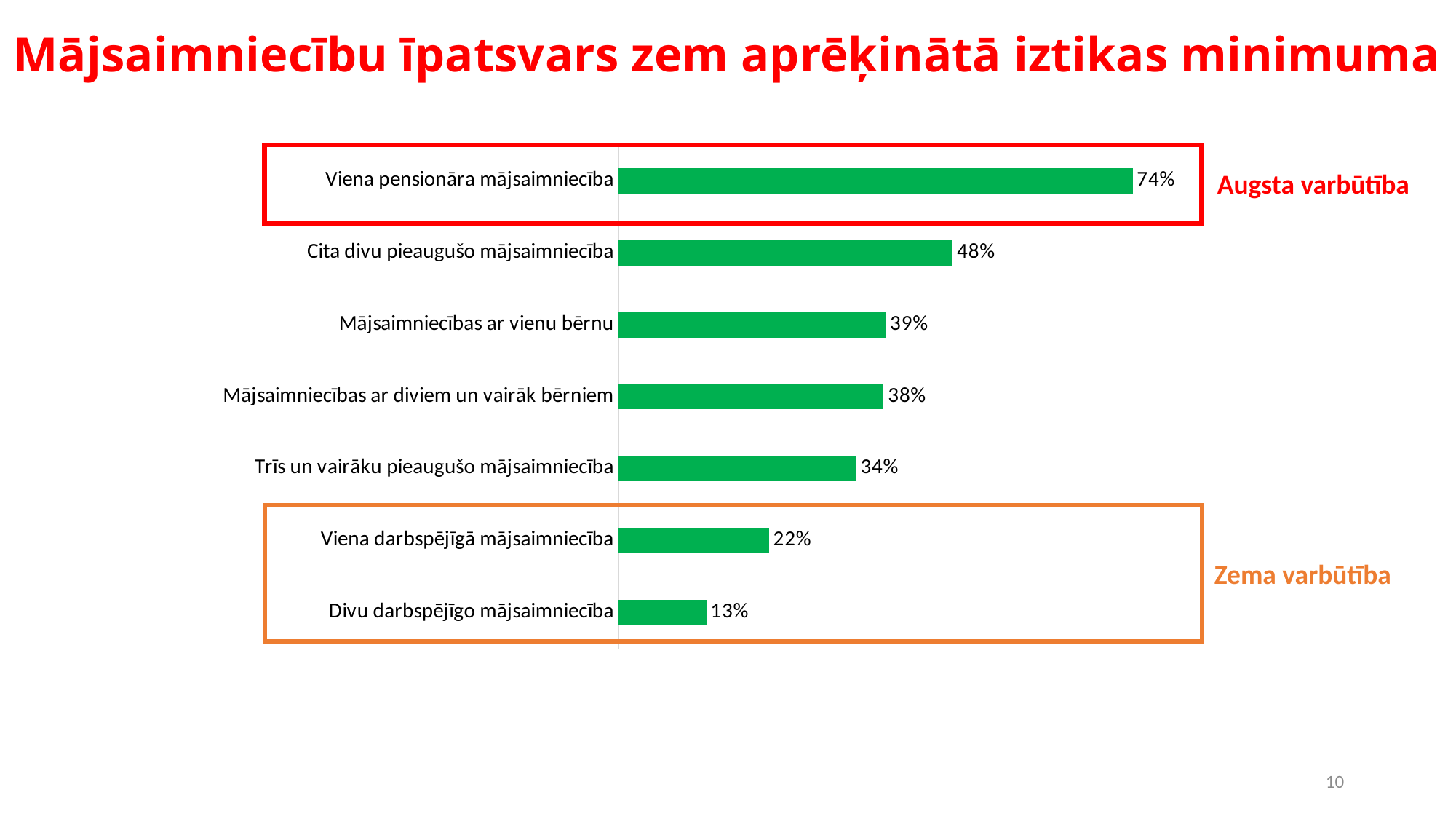
What is the value for Mājsaimniecības ar diviem un vairāk bērniem? 38% Which category has the lowest value? Divu darbspējīgo mājsaimniecība What is the difference between the values for Viena pensionāra mājsaimniecība and Cita divu pieaugušo mājsaimniecība? 26% What is the value for Divu darbspējīgo mājsaimniecība? 13% Which category has the highest value? Viena pensionāra mājsaimniecība How many categories are shown in the chart? 7 Which is larger: the value for Trīs un vairāku pieaugušo mājsaimniecība or the value for Viena darbspējīgā mājsaimniecība? Trīs un vairāku pieaugušo mājsaimniecība What kind of chart is shown on the slide? Bar chart What is the value for Viena pensionāra mājsaimniecība? 74% What is the difference between the values for Viena darbspējīgā mājsaimniecība and Divu darbspējīgo mājsaimniecība? 9% What is the value for Mājsaimniecības ar vienu bērnu? 39% Which label is shown next to the red box around the top bar? Augsta varbūtība